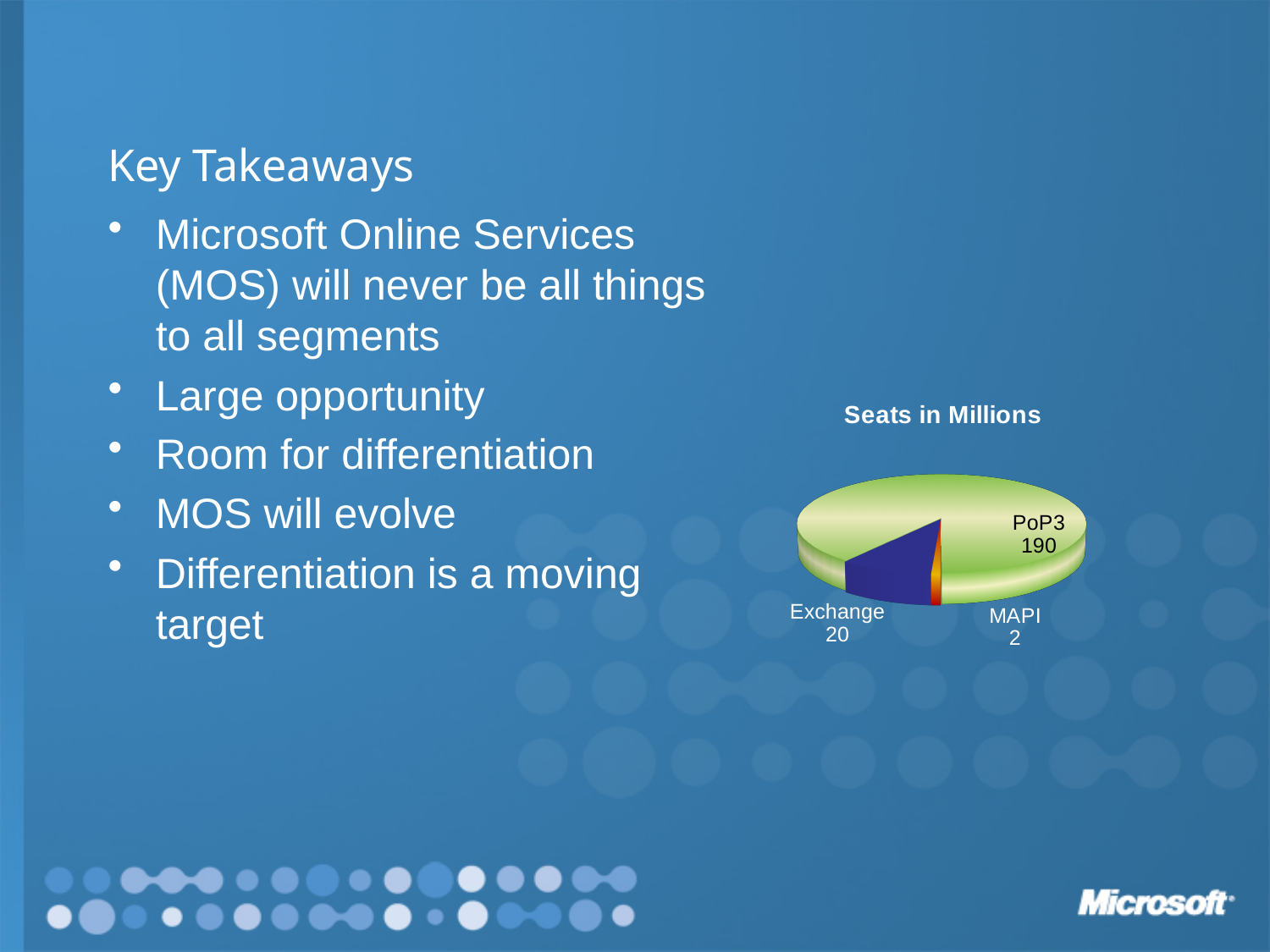
What is the total of all slices in the pie chart? 212 How many slices does the pie chart have? 3 What is the title of the pie chart? Seats in Millions What is the difference between the PoP3 and Exchange values? 170 Which category has the largest slice in the pie chart? PoP3 What type of chart is shown on the slide? pie chart Which is larger, Exchange or MAPI? Exchange What is the difference between the Exchange and MAPI values? 18 Which category has the smallest slice in the pie chart? MAPI What is the value for MAPI in the pie chart? 2 What is the value for PoP3 in the pie chart? 190 What is the value for Exchange in the pie chart? 20